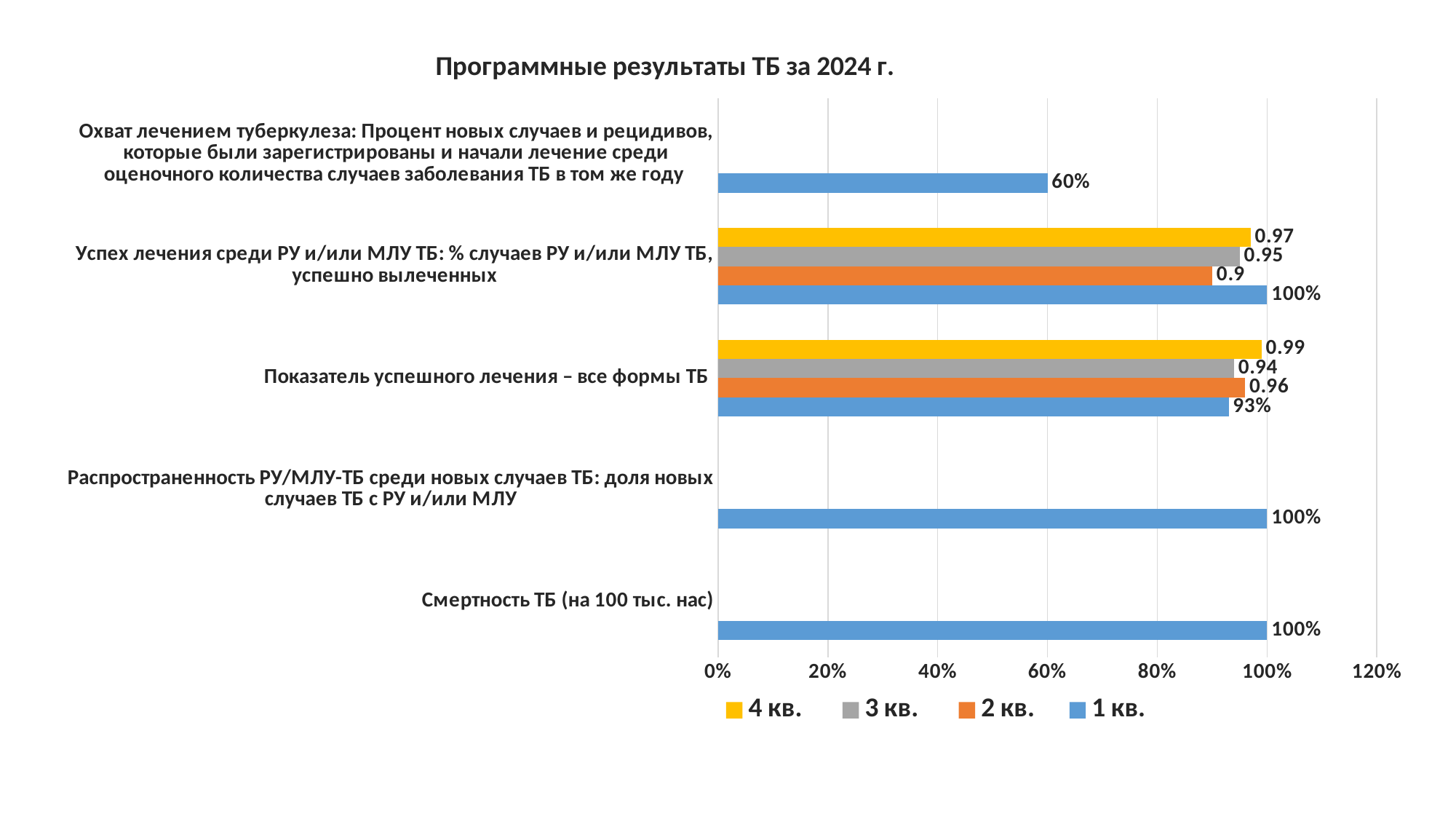
What is the 1 кв. value for "Показатель успешного лечения – все формы ТБ"? 93% How many series does the legend list? 4 What is the 3 кв. value for "Успех лечения среди РУ и/или МЛУ ТБ"? 0.95 What is the title of the chart? Программные результаты ТБ за 2024 г. Is the 1 кв. value for "Охват лечением туберкулеза" greater or less than 80%? less What is the 2 кв. value for "Успех лечения среди РУ и/или МЛУ ТБ"? 0.9 For "Показатель успешного лечения – все формы ТБ", which is larger: the 2 кв. value or the 3 кв. value? 2 кв. What is the 4 кв. value for "Показатель успешного лечения – все формы ТБ"? 0.99 What kind of chart is shown on the slide? bar chart How many categories are shown on the vertical axis of the chart? 5 What is the 1 кв. value for "Охват лечением туберкулеза"? 60% Which series has the lowest value for "Успех лечения среди РУ и/или МЛУ ТБ"? 2 кв.